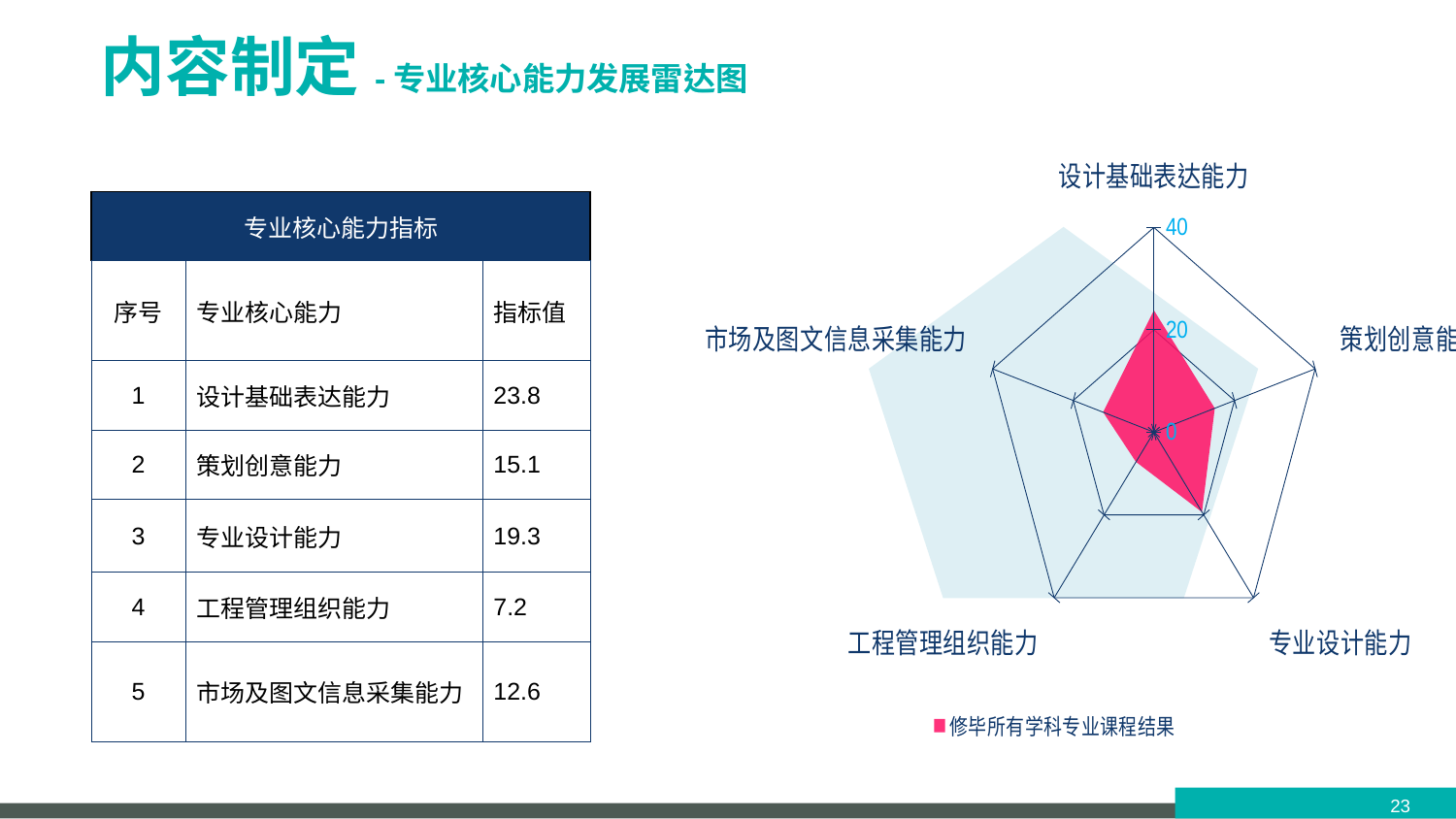
What is the value for 市场及图文信息采集能力? 12.6 How many categories (axes) does the radar chart have? 5 Which category has the lowest value on the radar chart? 工程管理组织能力 What is the value for 工程管理组织能力? 7.2 How many series does the legend of the radar chart list? 1 What is the value for 设计基础表达能力? 23.8 Which category has the highest value on the radar chart? 设计基础表达能力 What is the legend entry for the series plotted on the radar chart? 修毕所有学科专业课程结果 On the radar chart, is the value for 工程管理组织能力 greater or less than 20? less Which is larger, the value for 专业设计能力 or the value for 市场及图文信息采集能力? 专业设计能力 What kind of chart is shown on the slide? Radar chart What is the difference between the values for 设计基础表达能力 and 策划创意能力? 8.7